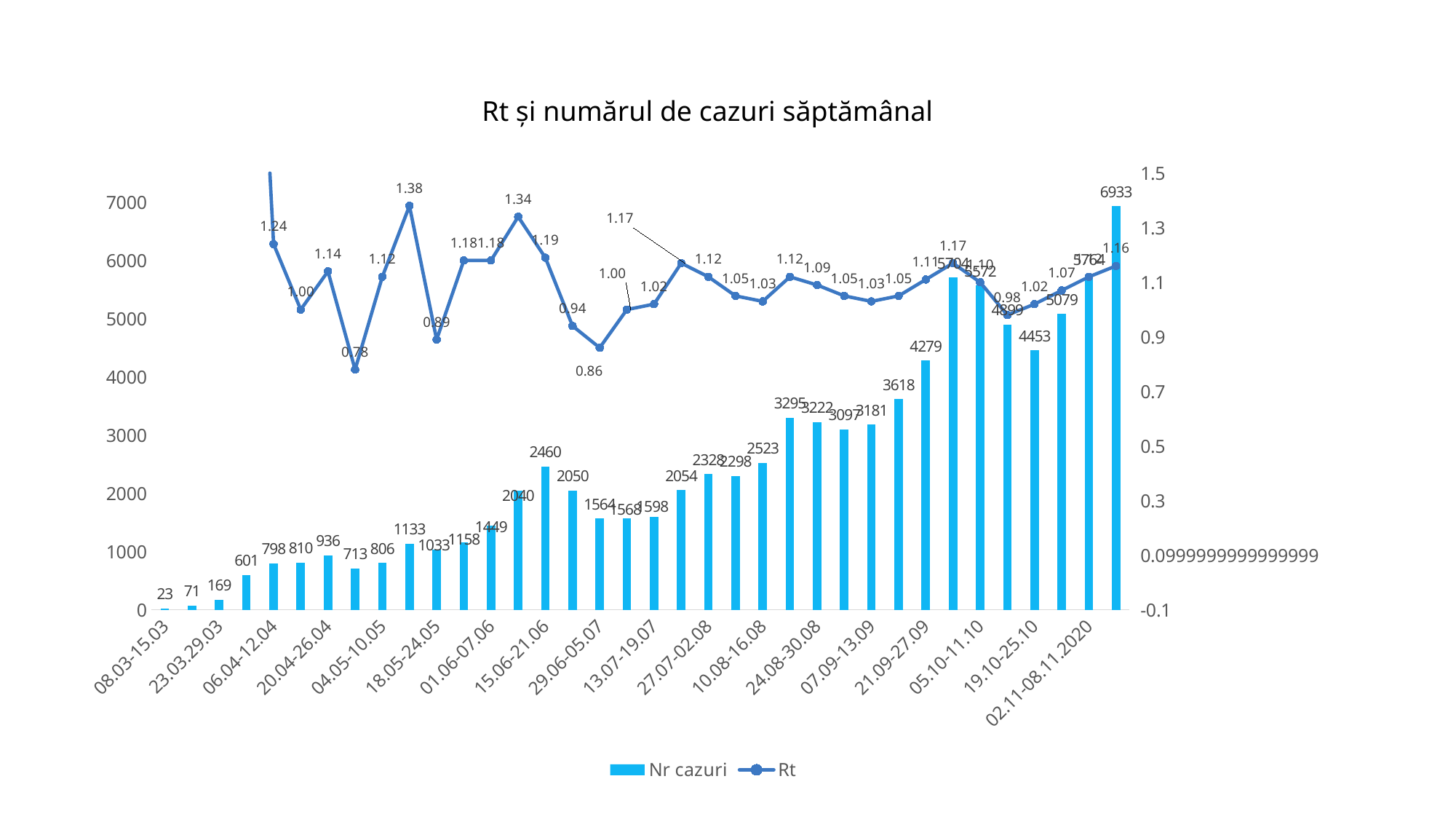
How many series does the legend list? 2 What is the lowest labelled Rt value on the chart? 0.78 What is the highest labelled Rt value on the chart? 1.38 What is the lowest weekly number of cases (Nr cazuri) shown on the chart? 23 Overall, do the weekly case numbers (Nr cazuri) rise or fall from left to right along the x axis? Rise What is the title of the chart? Rt și numărul de cazuri săptămânal What is the number of cases (Nr cazuri) for the week 08.03-15.03? 23 What kind of chart is shown on the slide? A combined bar and line chart What are the two series named in the legend? Nr cazuri and Rt What is the difference between the two highest case bars, 6933 and 5764? 1169 What is the highest weekly number of cases (Nr cazuri) shown on the chart? 6933 Which is larger, the case bar labelled 3295 or the one labelled 3618? 3618